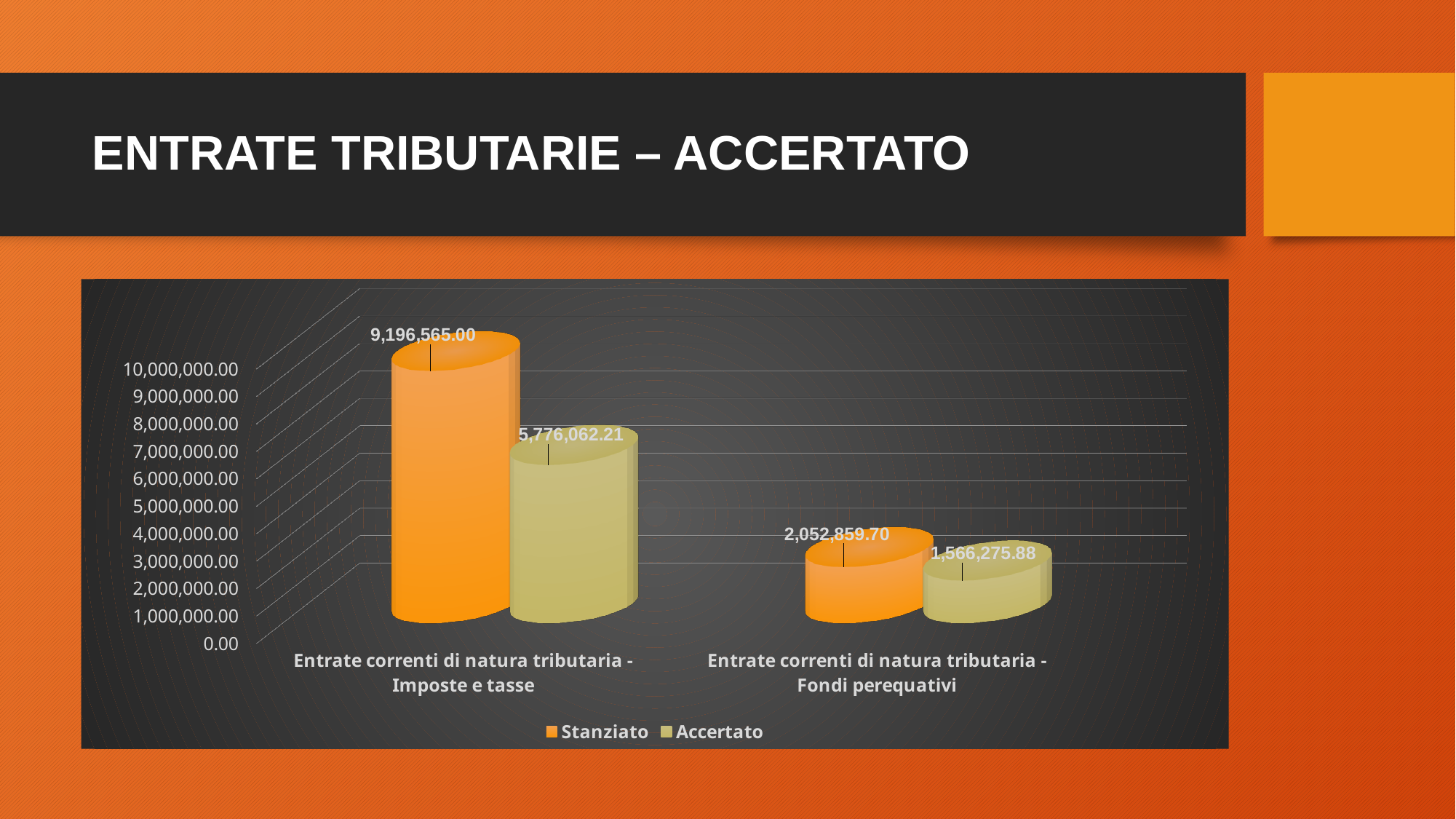
What is the Stanziato value for Entrate correnti di natura tributaria - Imposte e tasse? 9,196,565.00 What is the Stanziato value for Entrate correnti di natura tributaria - Fondi perequativi? 2,052,859.70 What is the Accertato value for Entrate correnti di natura tributaria - Imposte e tasse? 5,776,062.21 What is the Accertato value for Entrate correnti di natura tributaria - Fondi perequativi? 1,566,275.88 Which bar has the highest value on the chart? Stanziato for Entrate correnti di natura tributaria - Imposte e tasse How many series does the chart legend list? 2 What is the difference between the Stanziato and Accertato values for Entrate correnti di natura tributaria - Imposte e tasse? 3,420,502.79 What kind of chart is shown on the slide? Bar chart How many categories are shown on the x axis of the chart? 2 Which bar has the lowest value on the chart? Accertato for Entrate correnti di natura tributaria - Fondi perequativi Which is larger for Entrate correnti di natura tributaria - Fondi perequativi: Stanziato or Accertato? Stanziato What is the difference between the Stanziato and Accertato values for Entrate correnti di natura tributaria - Fondi perequativi? 486,583.82